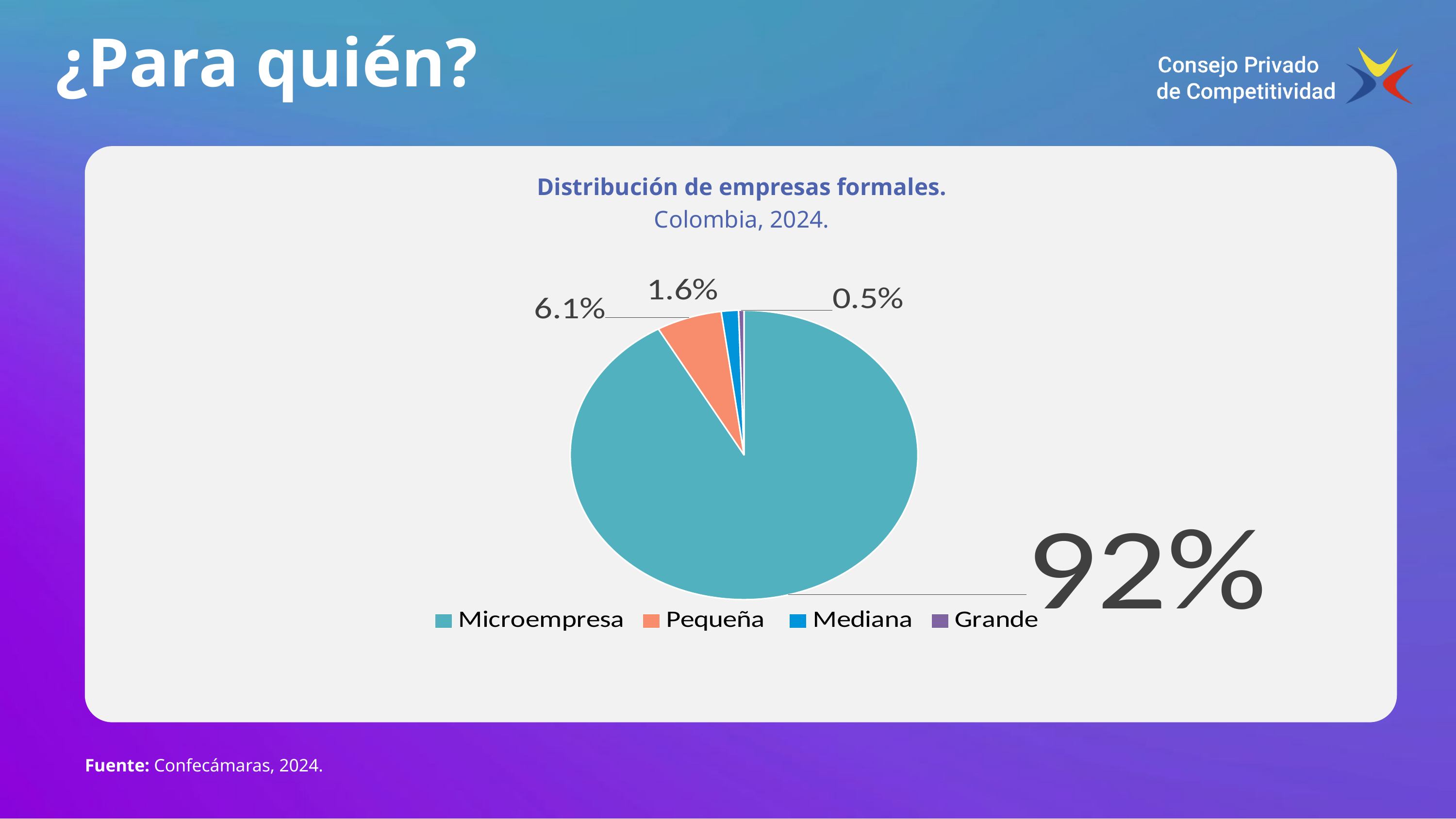
What share of formal companies are Mediana? 1.6% Which category has the largest slice of the pie? Microempresa Which is larger, the share for Pequeña or the share for Mediana? Pequeña What share of formal companies are Pequeña? 6.1% What share of formal companies are Microempresa? 92% Which category has the smallest slice of the pie? Grande What kind of chart is shown on the slide? Pie chart What is the title of the chart? Distribución de empresas formales. Colombia, 2024. What colour is the Pequeña slice in the pie chart? Orange How many categories does the legend list? 4 What share of formal companies are Grande? 0.5% What is the difference in percentage points between the Pequeña and Mediana shares? 4.5